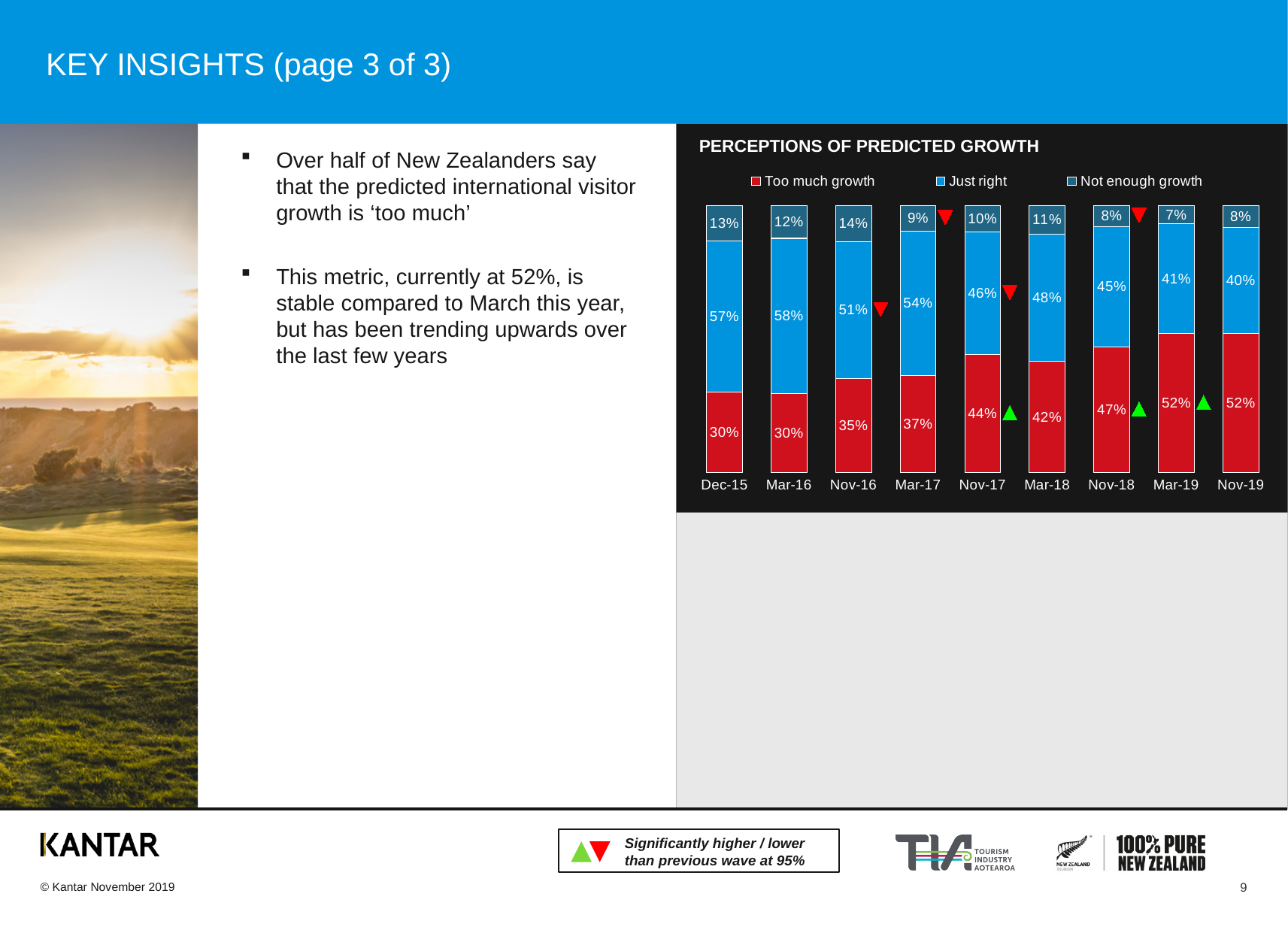
What is the chart's title? PERCEPTIONS OF PREDICTED GROWTH What is the value for 'Just right' in Mar-16? 58% In which period is the 'Not enough growth' value lowest? Mar-19 What is the value for 'Too much growth' in Nov-19? 52% What is the difference between the 'Too much growth' values in Nov-19 and Dec-15? 22% What type of chart is shown on the slide? Stacked bar chart Which is larger in Nov-17: 'Too much growth' or 'Just right'? Just right How does the 'Too much growth' value change from Dec-15 to Nov-19? It rises How many series does the legend list? 3 What is the value for 'Not enough growth' in Mar-19? 7% How many time periods are shown along the x axis? 9 In which period is the 'Just right' value highest? Mar-16